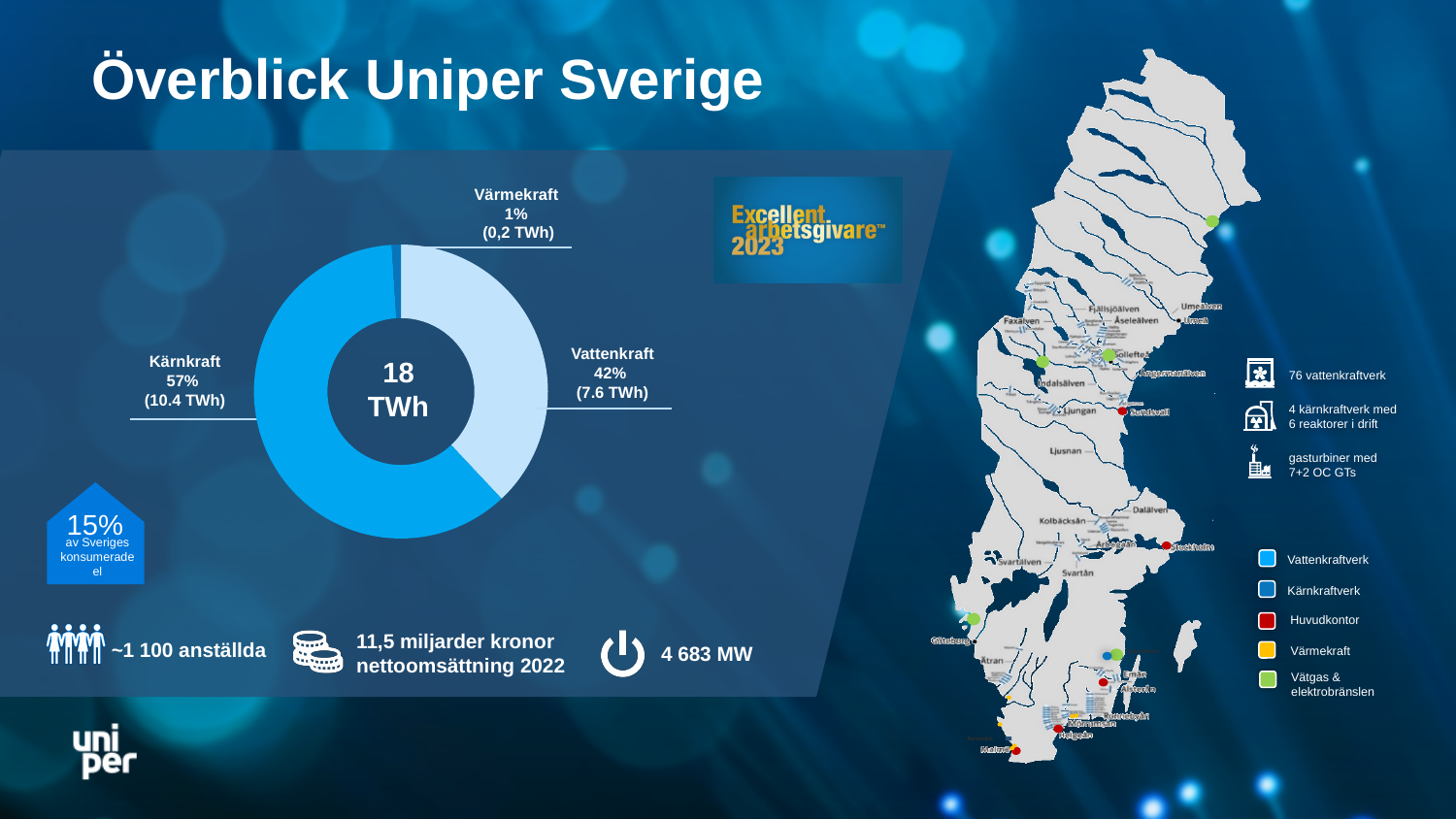
What share of the donut chart does Kärnkraft represent? 57% How many TWh does the Värmekraft slice represent? 0,2 TWh Which category has the largest slice in the donut chart? Kärnkraft How many TWh does the Vattenkraft slice represent? 7.6 TWh What kind of chart is shown on the left of the slide? Donut (pie) chart What total value is printed in the centre of the donut chart? 18 TWh How many TWh does the Kärnkraft slice represent? 10.4 TWh Which category has the smallest slice in the donut chart? Värmekraft What is the difference in percentage points between the Kärnkraft and Vattenkraft shares? 15 percentage points What share of the donut chart does Vattenkraft represent? 42% How many categories are shown in the donut chart? 3 What share of the donut chart does Värmekraft represent? 1%